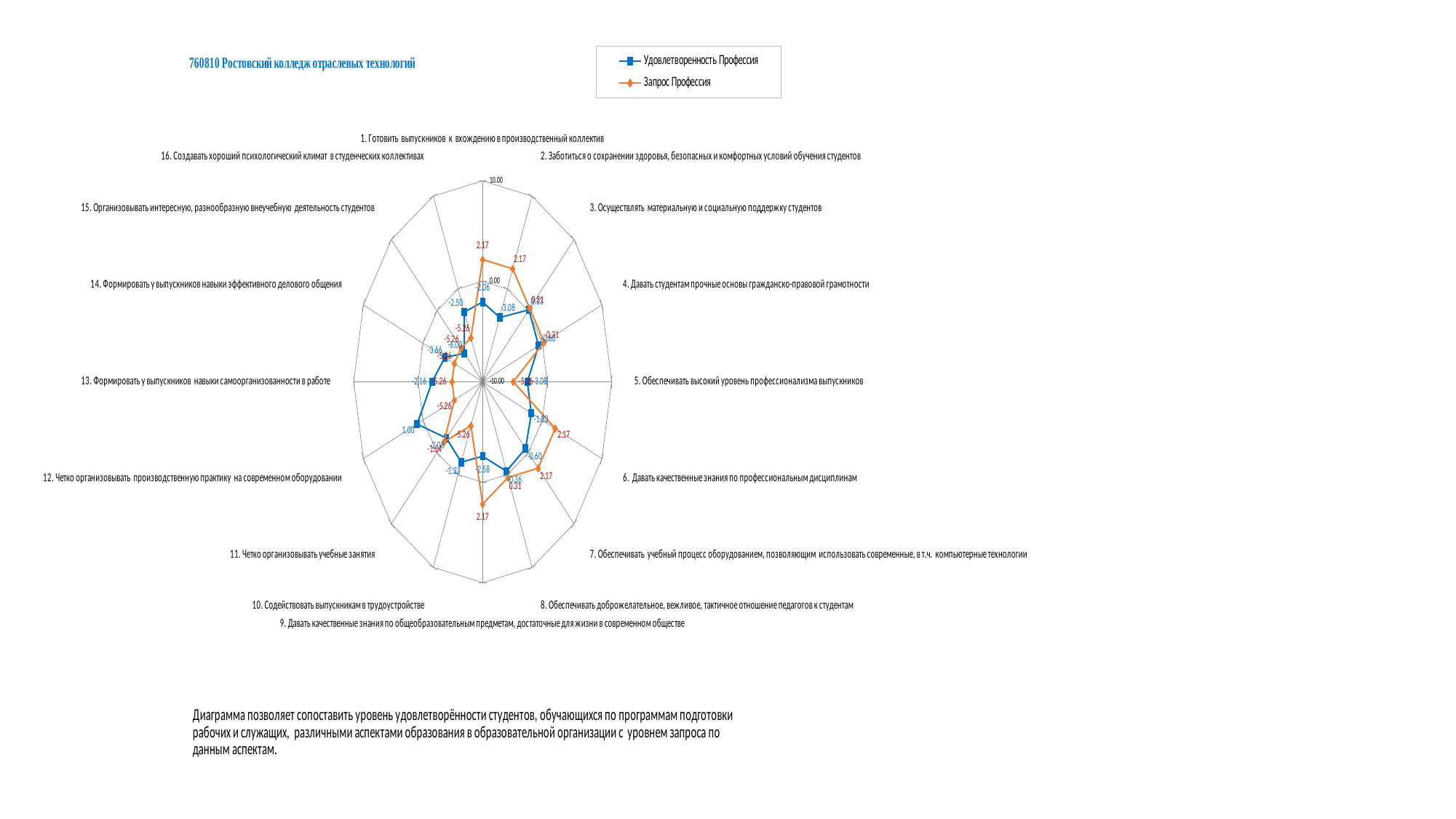
What is the value of Удовлетворенность Профессия for category 9 (Давать качественные знания по общеобразовательным предметам)? -2.58 For category 1, which series has the larger value, Удовлетворенность Профессия or Запрос Профессия? Запрос Профессия What is the value of Удовлетворенность Профессия for category 12 (Четко организовывать производственную практику на современном оборудовании)? 1.00 How many series does the legend list? 2 What is the value of Удовлетворенность Профессия for category 1 (Готовить выпускников к вхождению в производственный коллектив)? -2.06 How many categories (axes) does the radar chart have? 16 What kind of chart is shown on the slide? Radar chart What is the title of the chart? 760810 Ростовский колледж отраслевых технологий What are the two series named in the legend? Удовлетворенность Профессия and Запрос Профессия What is the value of Запрос Профессия for category 1 (Готовить выпускников к вхождению в производственный коллектив)? 2.17 For which category is the Удовлетворенность Профессия value highest? 12. Четко организовывать производственную практику на современном оборудовании What is the difference between Запрос Профессия and Удовлетворенность Профессия for category 9 (2.17 and -2.58)? 4.75